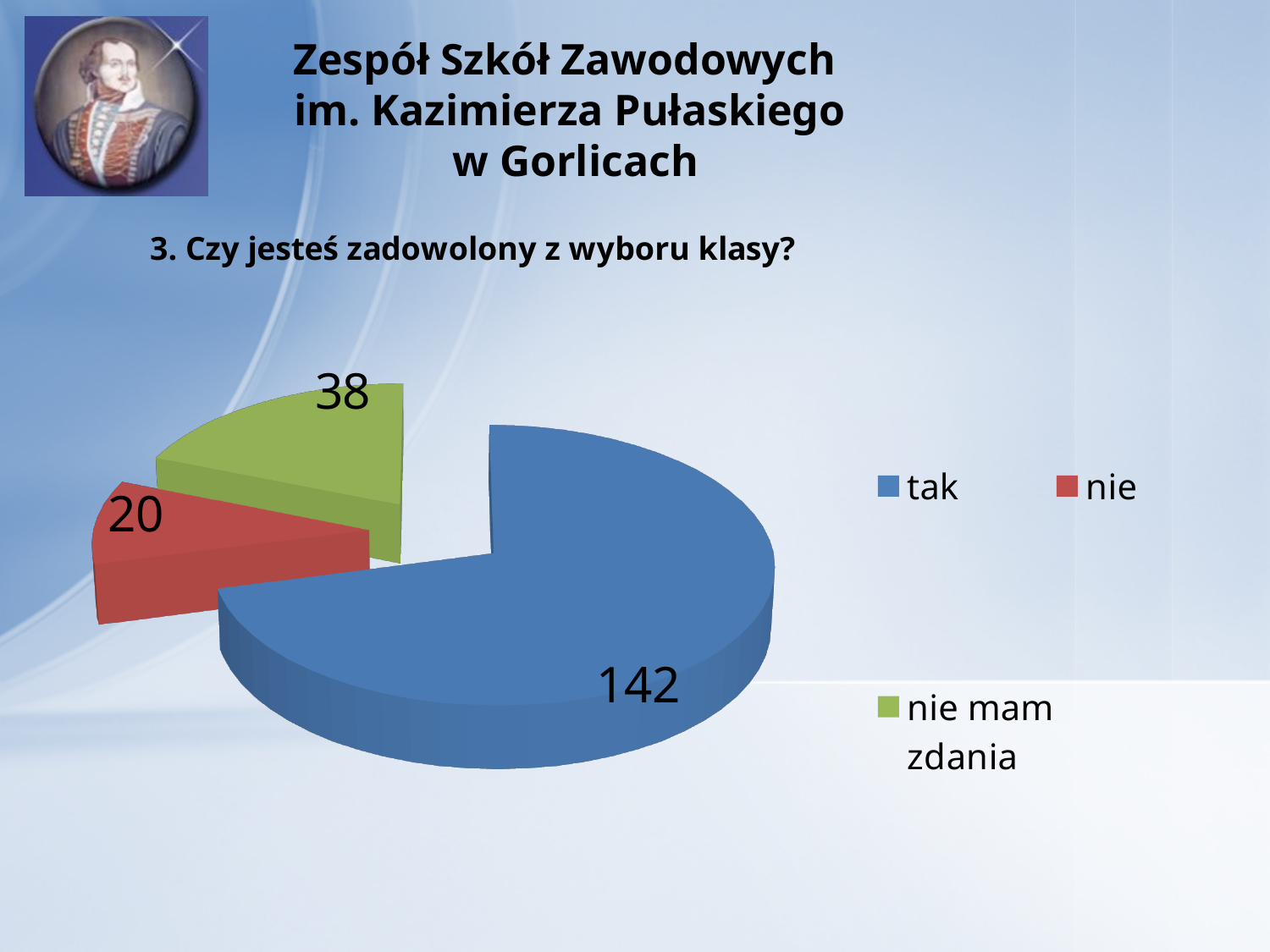
What kind of chart is shown on the slide? pie chart How many slices does the pie chart have? 3 Which is larger, the value for "nie" or the value for "nie mam zdania"? nie mam zdania What share of the pie does "tak" represent? 71% What is the difference between the values for "tak" and "nie mam zdania"? 104 What is the value for "nie mam zdania"? 38 What is the value for "nie"? 20 Which category has the smallest slice? nie What is the value for "tak"? 142 What colour is the "nie" slice? red What is the total of all slices in the pie chart? 200 Which category has the largest slice? tak